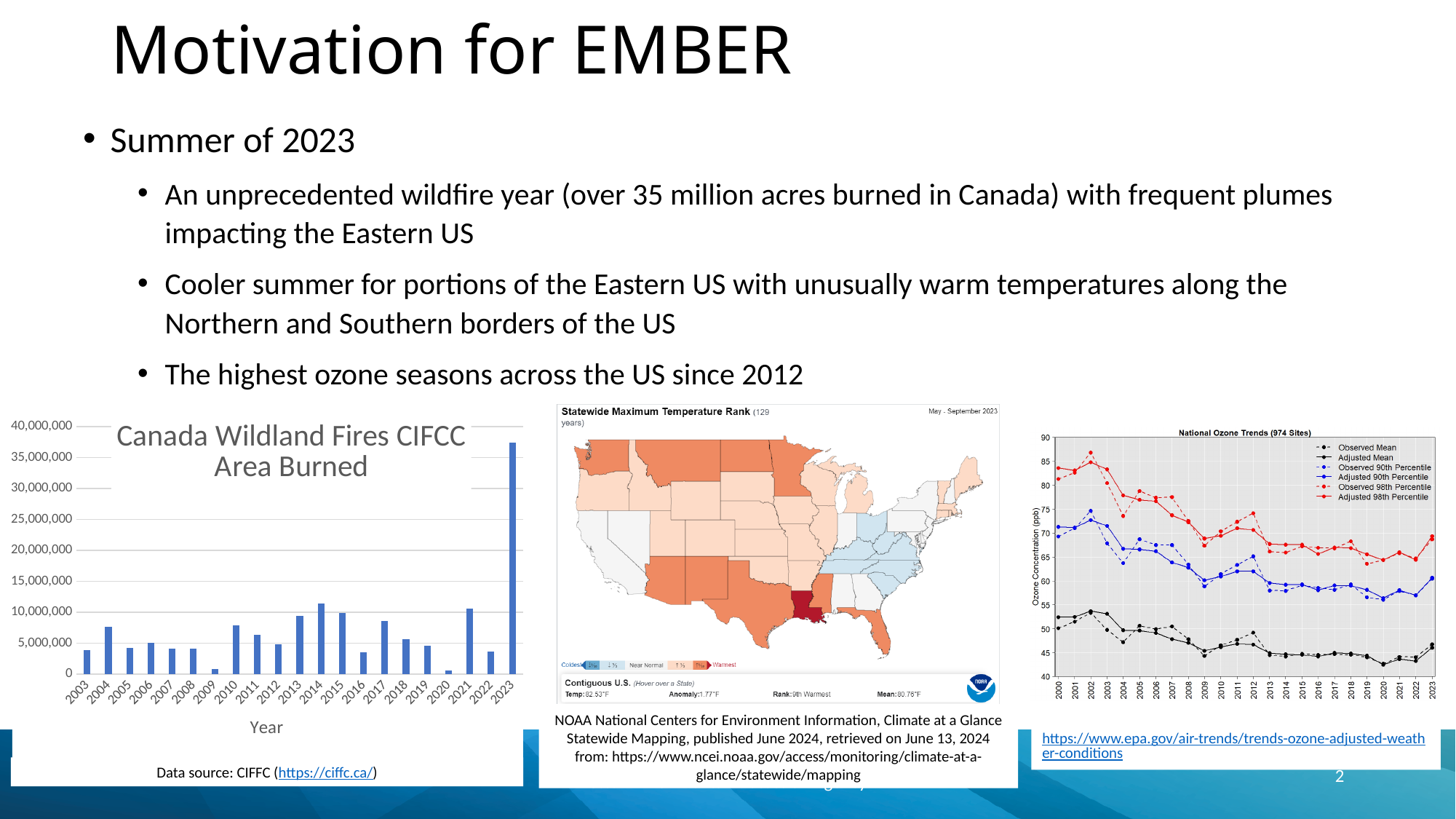
What is the x-axis label of the Canada Wildland Fires CIFCC Area Burned chart? Year How many years are shown in the Canada Wildland Fires CIFCC Area Burned chart? 21 What type of chart is the National Ozone Trends (974 Sites) chart? line chart In the Canada Wildland Fires CIFCC Area Burned chart, which year has the larger area burned, 2004 or 2003? 2004 In the National Ozone Trends (974 Sites) chart, is the Adjusted Mean value for 2020 greater or less than 45? less In the Canada Wildland Fires CIFCC Area Burned chart, is the value for 2023 greater or less than 35,000,000? greater In the Canada Wildland Fires CIFCC Area Burned chart, is the value for 2003 greater or less than 5,000,000? less How many series does the legend of the National Ozone Trends (974 Sites) chart list? 6 In the Canada Wildland Fires CIFCC Area Burned chart, which year has the highest area burned? 2023 In the National Ozone Trends (974 Sites) chart, does the Adjusted 98th Percentile series generally rise or fall from 2000 to 2023? fall What type of chart is the Canada Wildland Fires CIFCC Area Burned chart? bar chart